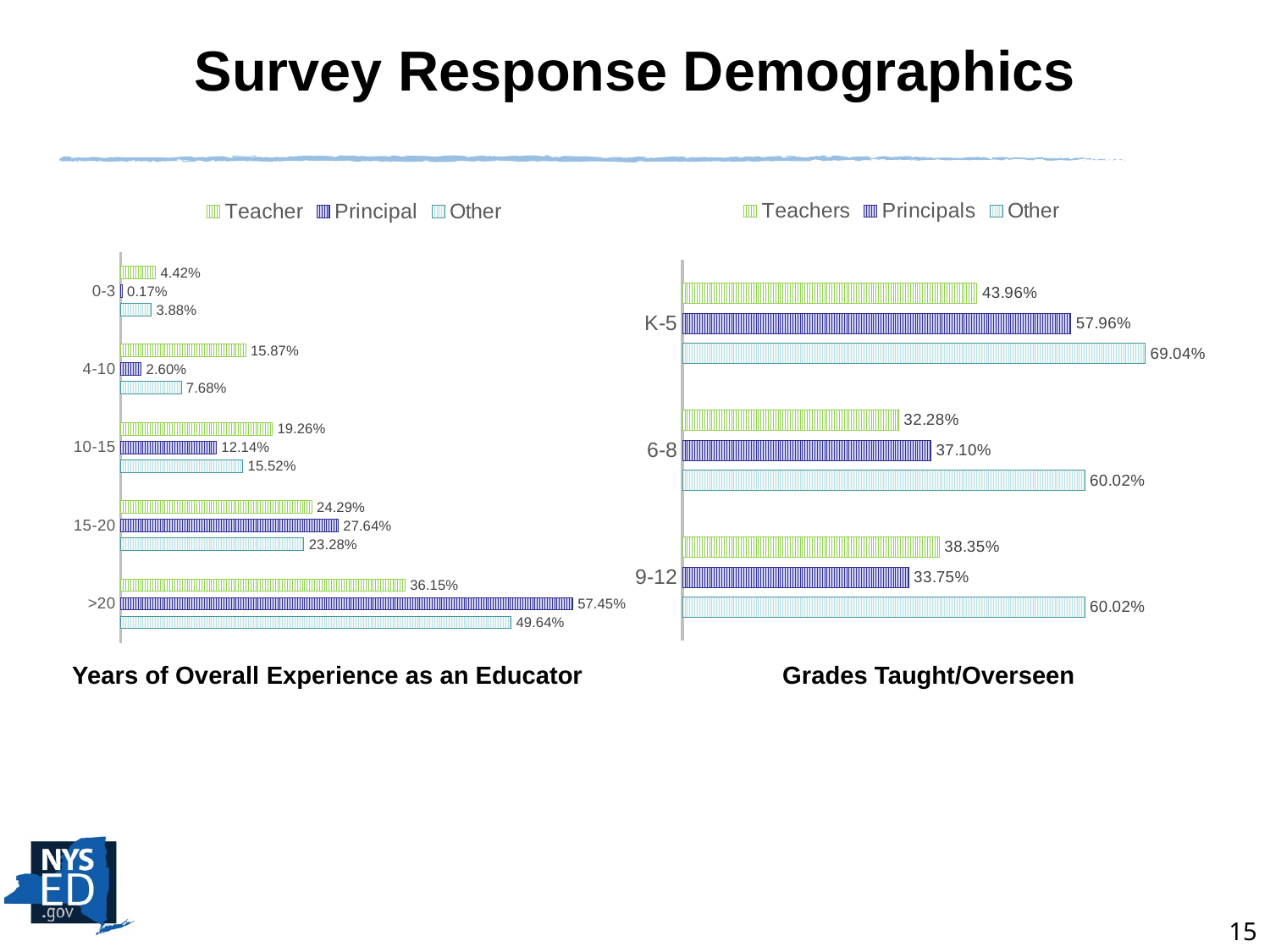
In the 'Years of Overall Experience as an Educator' chart, how many experience categories are shown? 5 In the 'Grades Taught/Overseen' chart, what is the difference between the Other and Teachers values for K-5? 25.08% What type of chart is the 'Grades Taught/Overseen' chart? Bar chart In the 'Years of Overall Experience as an Educator' chart, what is the difference between the Principal and Teacher values for the >20 category? 21.30% In the 'Years of Overall Experience as an Educator' chart, what is the Teacher value for the 4-10 category? 15.87% In the 'Grades Taught/Overseen' chart, what is the Other value for K-5? 69.04% In the 'Years of Overall Experience as an Educator' chart, which category has the highest Other value? >20 In the 'Grades Taught/Overseen' chart, what is the Principals value for 6-8? 37.10% In the 'Grades Taught/Overseen' chart, which is larger for 9-12: the Teachers value or the Principals value? Teachers How many series does the legend of the 'Grades Taught/Overseen' chart list? 3 In the 'Years of Overall Experience as an Educator' chart, which category has the lowest Principal value? 0-3 In the 'Years of Overall Experience as an Educator' chart, what is the Principal value for the >20 category? 57.45%